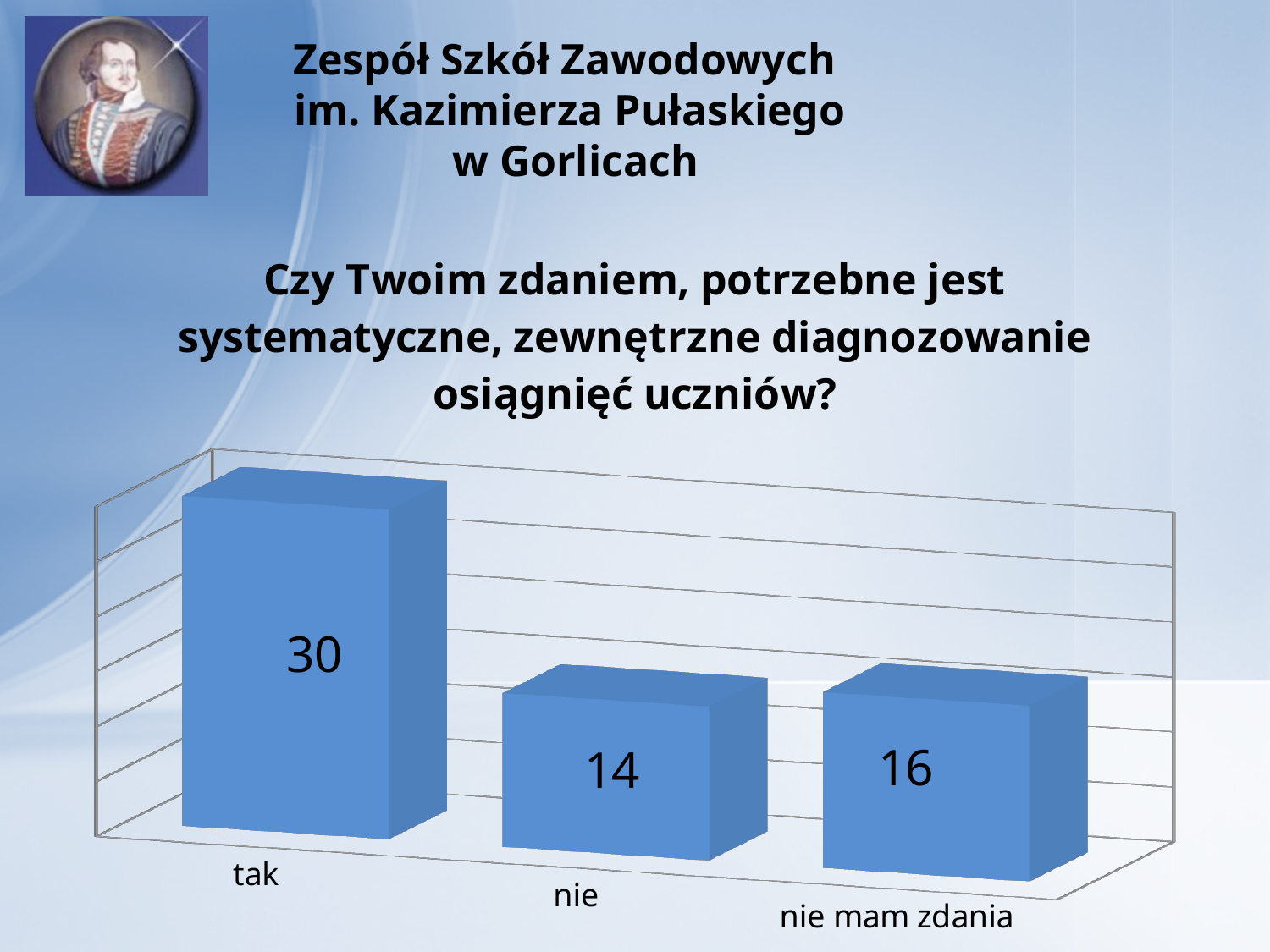
What is the value for "tak"? 30 What kind of chart is shown on the slide? bar chart Which category has the highest value? tak Which is larger, the value for "tak" or the value for "nie mam zdania"? tak What is the difference between the values for "nie mam zdania" and "nie"? 2 How many categories are shown in the chart? 3 What is the value for "nie mam zdania"? 16 Which category has the lowest value? nie What question does the chart on the slide present responses to? Czy Twoim zdaniem, potrzebne jest systematyczne, zewnętrzne diagnozowanie osiągnięć uczniów? What is the total of the three values shown in the chart? 60 What is the value for "nie"? 14 What is the difference between the values for "tak" and "nie"? 16